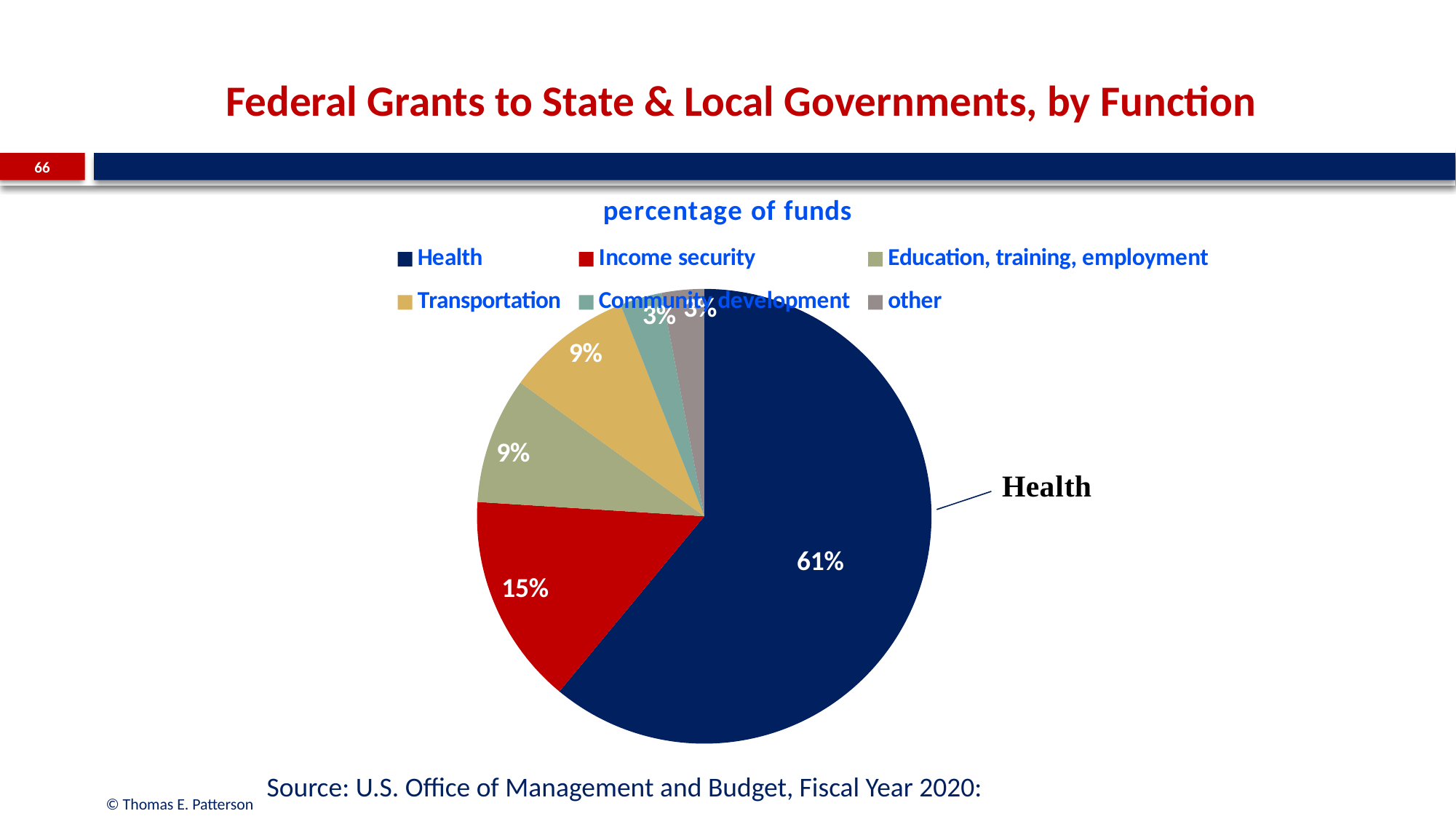
What is the difference in percentage points between Health and Income security? 46 How many categories does the legend list? 6 What is the difference in percentage points between Income security and Education, training, employment? 6 What kind of chart is shown on the slide? pie chart What percentage of funds goes to Income security? 15% Which receives a larger share of funds, Income security or Transportation? Income security What is the title of the chart? percentage of funds What percentage of funds goes to Transportation? 9% What colour is the Income security slice? red Which function receives the largest share of federal grants? Health What percentage of funds goes to Community development? 3% What percentage of funds goes to Health? 61%